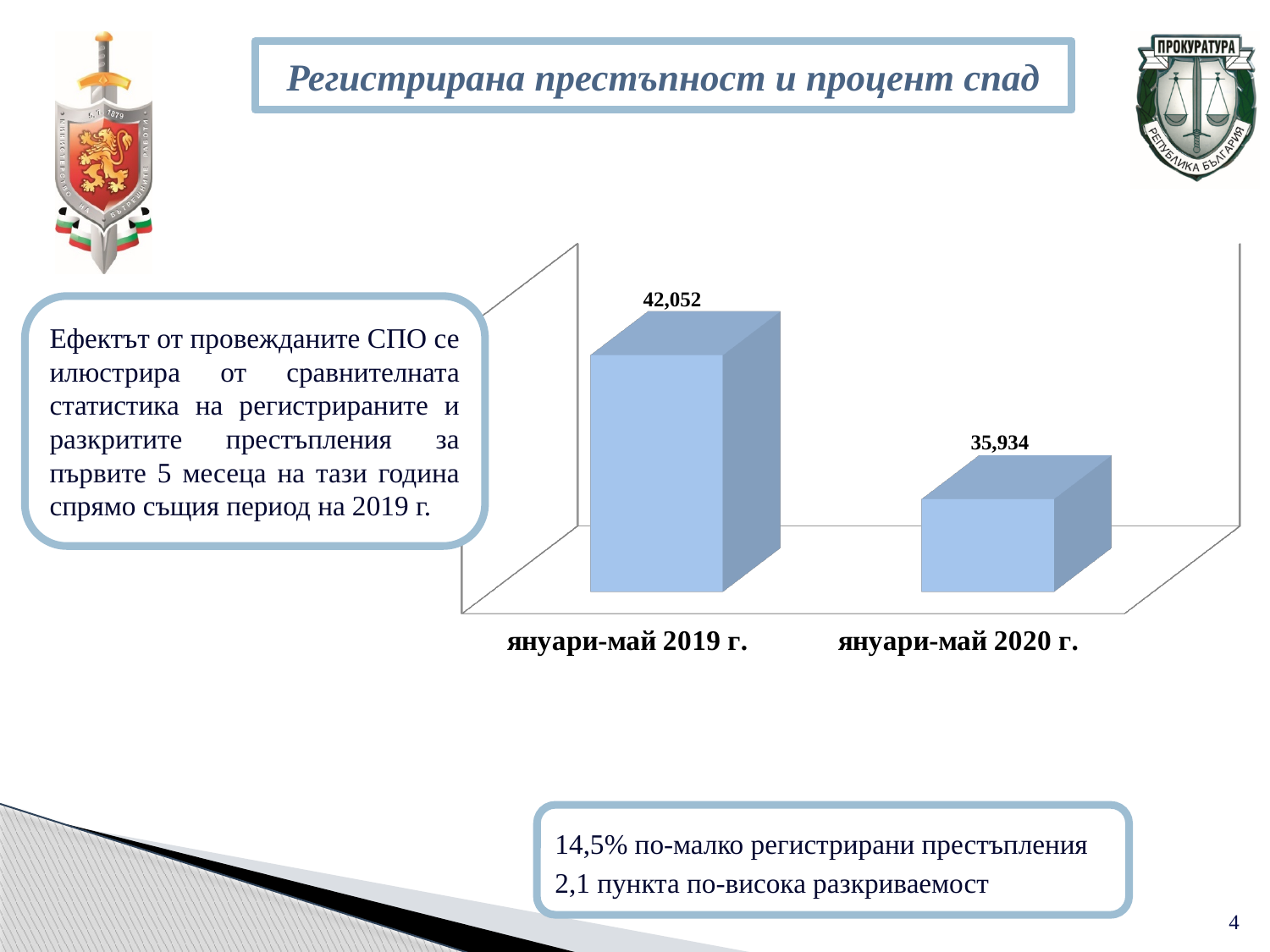
How many categories are shown in the chart? 2 What is the value for януари-май 2020 г.? 35,934 What kind of chart is shown on the slide? bar chart What colour are the bars in the chart? light blue What is the difference between the values for януари-май 2019 г. and януари-май 2020 г.? 6,118 What is the title of the slide containing the chart? Регистрирана престъпност и процент спад Which category has the lowest value? януари-май 2020 г. Which category has the highest value? януари-май 2019 г. Do the values rise or fall from януари-май 2019 г. to януари-май 2020 г.? fall Which is larger, the value for януари-май 2019 г. or for януари-май 2020 г.? януари-май 2019 г. What is the value for януари-май 2019 г.? 42,052